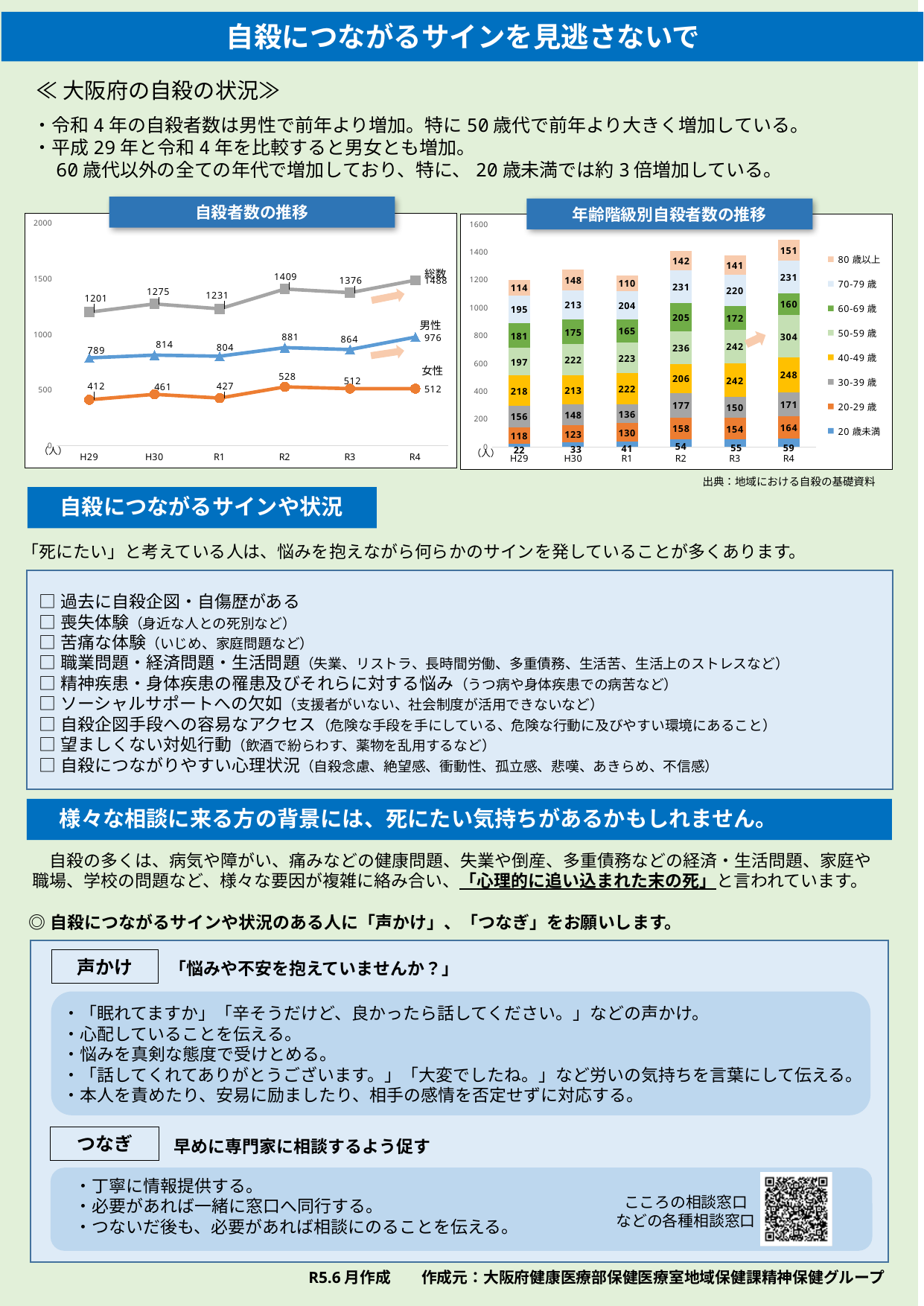
In the chart titled 自殺者数の推移, how many series are shown? 3 In the chart titled 年齢階級別自殺者数の推移, how many age groups does the legend list? 8 In the chart titled 自殺者数の推移, in which year is 男性 highest? R4 In the chart titled 年齢階級別自殺者数の推移, how many years are shown on the x axis? 6 In the chart titled 年齢階級別自殺者数の推移, what is the total of the stacked bar for R4? 1488 In the chart titled 年齢階級別自殺者数の推移, what is the value for 50-59歳 in R4? 304 In the chart titled 自殺者数の推移, what kind of chart is it? line chart In the chart titled 年齢階級別自殺者数の推移, what is the value for 20歳未満 in H29? 22 In the chart titled 自殺者数の推移, what is the value of 総数 for R4? 1488 In the chart titled 自殺者数の推移, what is the value of 女性 for H29? 412 In the chart titled 自殺者数の推移, what is the difference between 男性 and 女性 in R2? 353 In the chart titled 年齢階級別自殺者数の推移, which is larger in R3: 40-49歳 or 60-69歳? 40-49歳